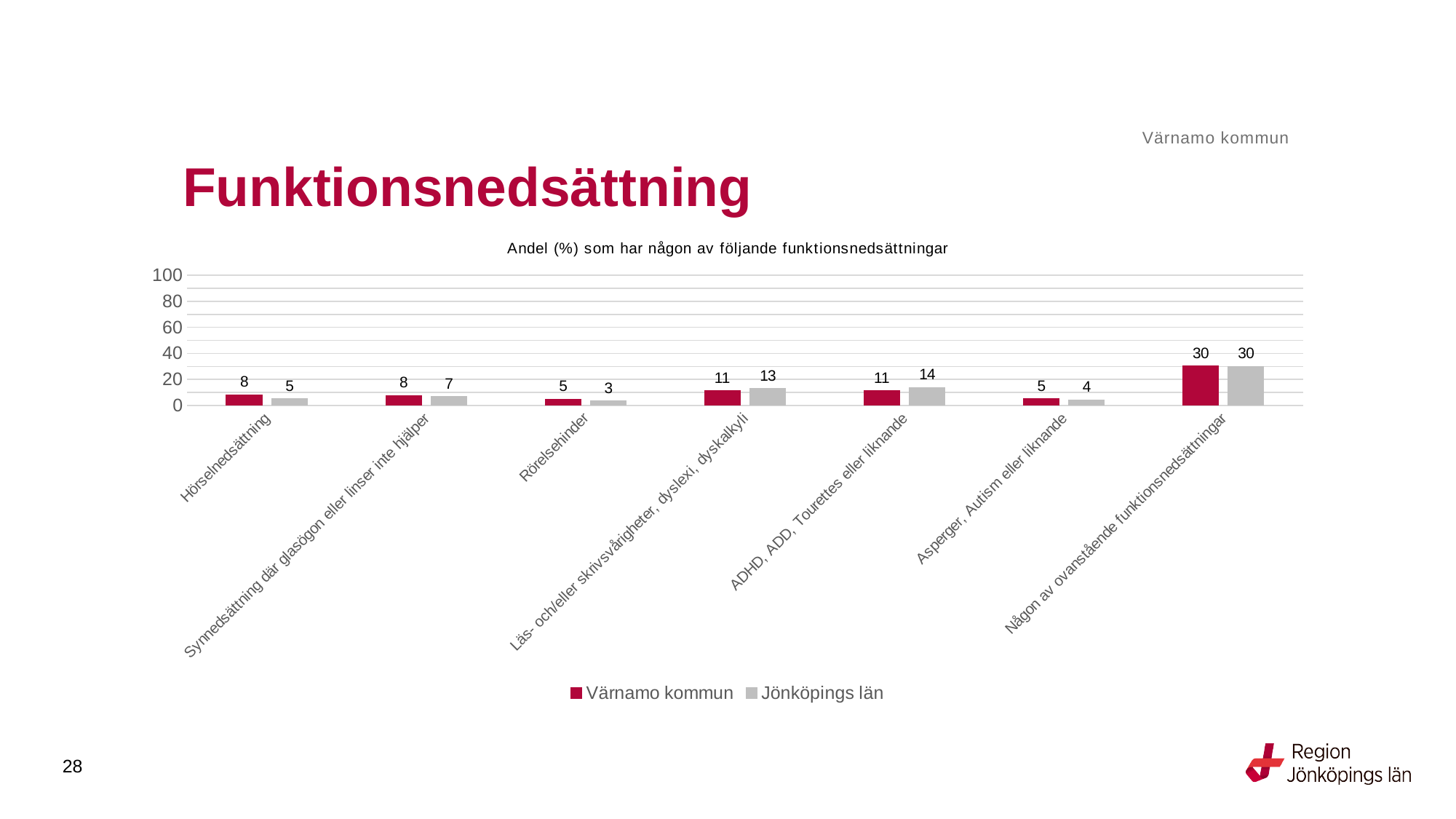
Is the value for Värnamo kommun for Någon av ovanstående funktionsnedsättningar greater or less than 20? greater Which category has the lowest value for Jönköpings län? Rörelsehinder How many categories are shown on the x axis? 7 What kind of chart is shown on the slide? bar chart What is the difference between Jönköpings län and Värnamo kommun for ADHD, ADD, Tourettes eller liknande? 3 How many series does the legend list? 2 What is the value for Värnamo kommun for Någon av ovanstående funktionsnedsättningar? 30 What is the title of the chart? Andel (%) som har någon av följande funktionsnedsättningar What is the value for Värnamo kommun for Hörselnedsättning? 8 What is the value for Jönköpings län for ADHD, ADD, Tourettes eller liknande? 14 Which category has the highest value for Jönköpings län? Någon av ovanstående funktionsnedsättningar Which is larger for Hörselnedsättning: Värnamo kommun or Jönköpings län? Värnamo kommun